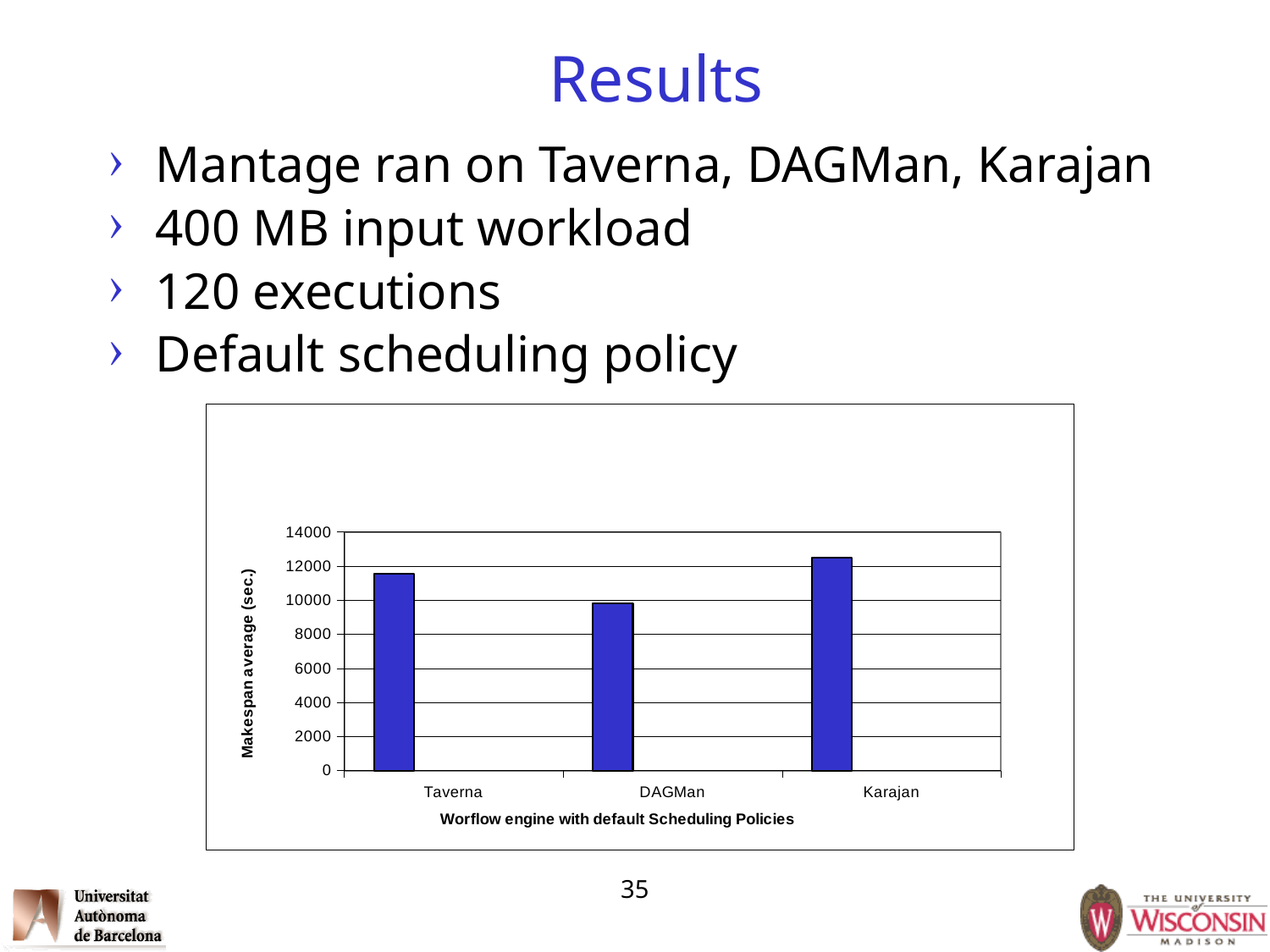
What is the label of the horizontal axis of the chart? Worflow engine with default Scheduling Policies Is the makespan average for Taverna greater or less than 10000? greater How many workflow engines are plotted on the x axis of the chart? 3 Is the makespan average for Karajan greater or less than 12000? greater Which has a larger makespan average, Taverna or DAGMan? Taverna Which workflow engine has the highest makespan average? Karajan Which has a larger makespan average, Karajan or Taverna? Karajan Which workflow engine has the lowest makespan average? DAGMan What is the label of the vertical axis of the chart? Makespan average (sec.) Is the makespan average for Taverna greater or less than 12000? less What kind of chart is shown on the slide? bar chart